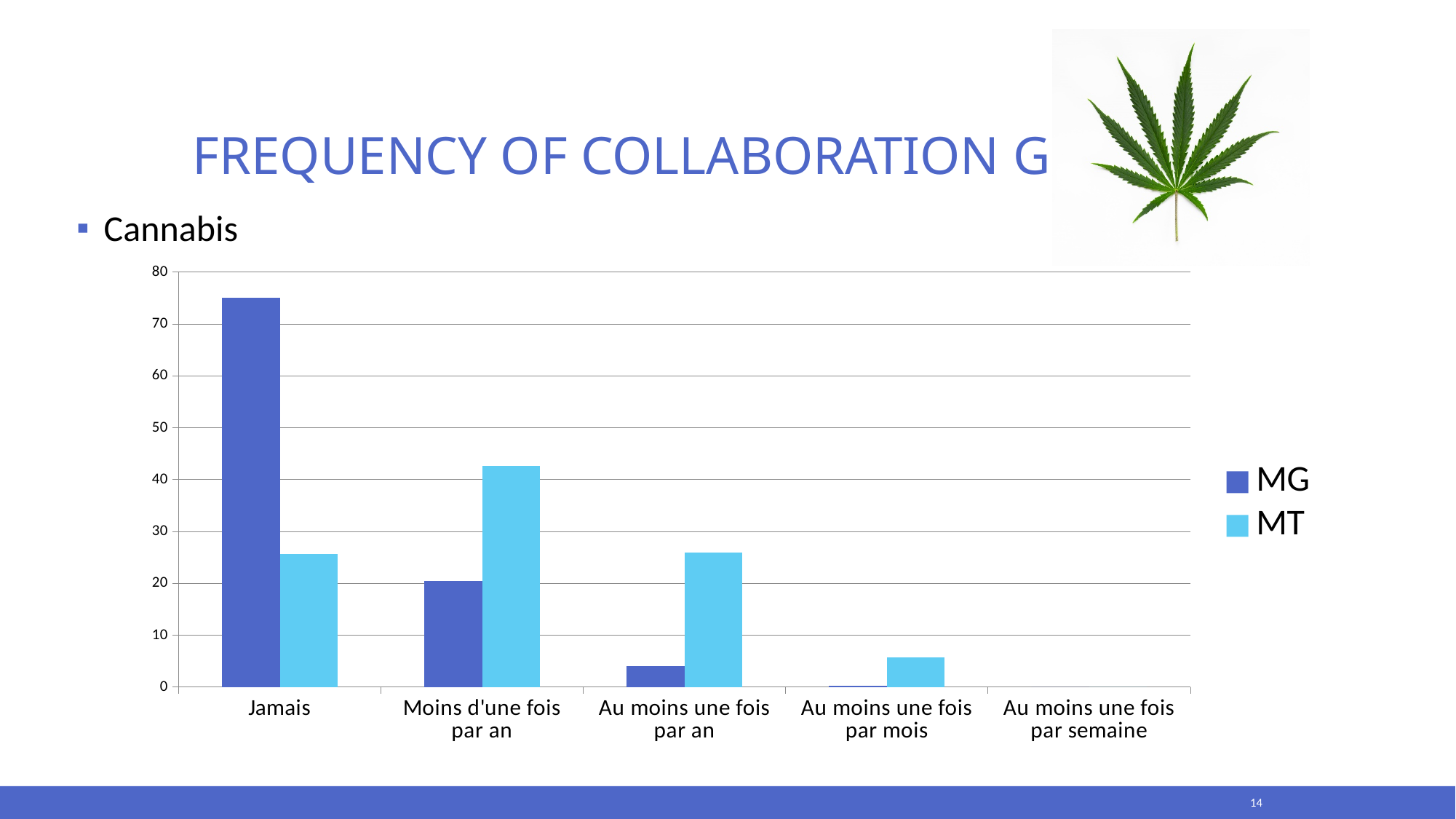
Is the MT value for Moins d'une fois par an greater or less than 40? greater For Au moins une fois par an, which series has the larger value, MG or MT? MT Is the MT value for Au moins une fois par mois greater or less than 10? less Which category has the highest MT value? Moins d'une fois par an How many categories are shown on the x axis? 5 How many series does the legend list? 2 What kind of chart is shown on the slide? bar chart Is the MG value for Moins d'une fois par an greater or less than 30? less Which category has the highest MG value? Jamais For Jamais, which series has the larger value, MG or MT? MG What are the two series named in the legend? MG and MT